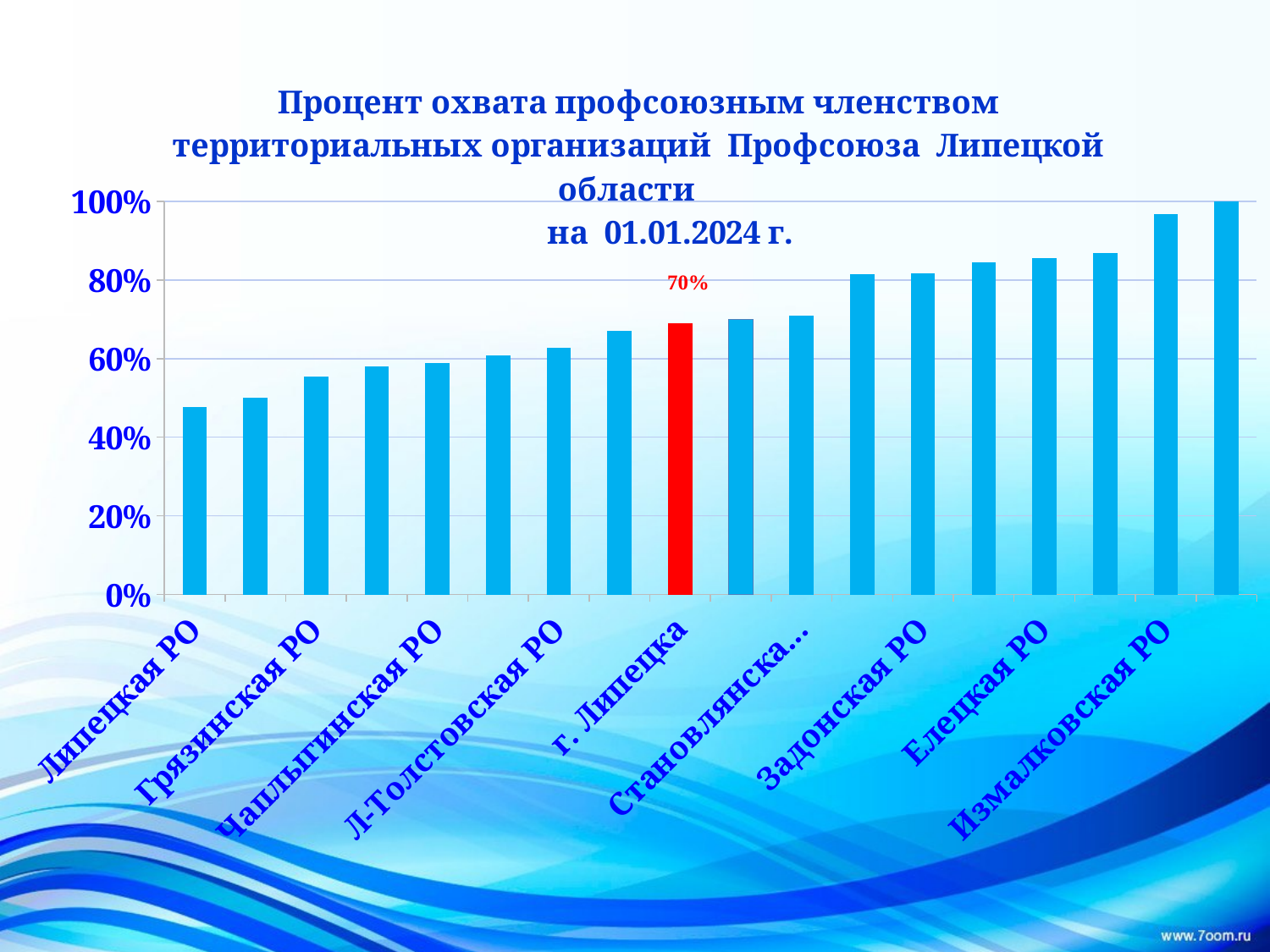
Is the value for Елецкая РО greater or less than 80%? greater What is the value shown for г. Липецка? 70% Is the value for Измалковская РО greater or less than 80%? greater What kind of chart is shown on the slide? bar chart Which has a larger value, Измалковская РО or Липецкая РО? Измалковская РО Which has a larger value, Елецкая РО or Грязинская РО? Елецкая РО Is the value for Липецкая РО greater or less than 60%? less Which labelled organisation has the lowest value on the chart? Липецкая РО Do the values generally rise or fall from left to right along the x axis? rise Which bar is highlighted in red on the chart? г. Липецка